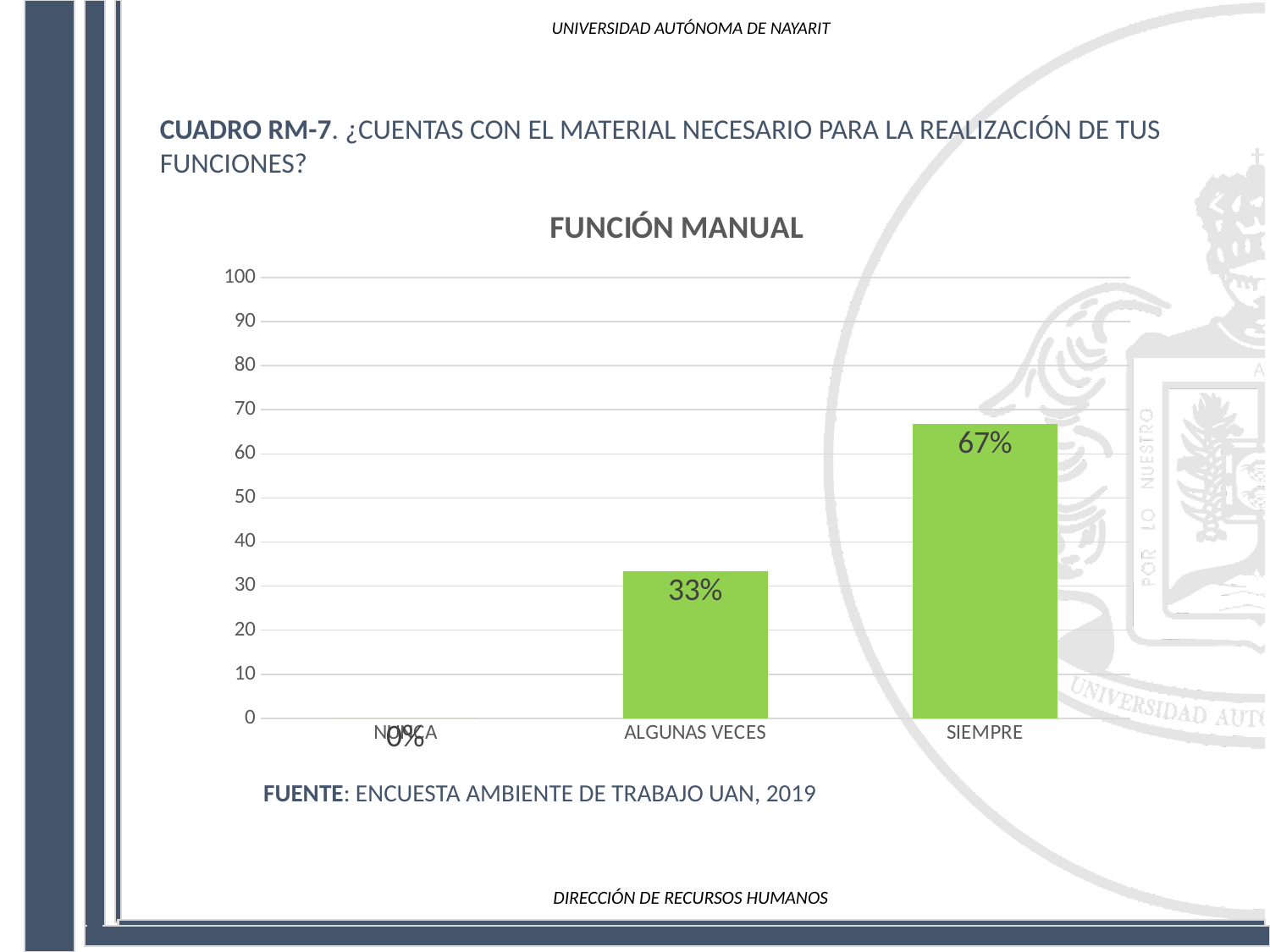
Which category has the highest value? SIEMPRE What is the difference between the values for SIEMPRE and ALGUNAS VECES? 34% What kind of chart is shown on the slide? bar chart How many categories are shown on the x axis? 3 What is the value for SIEMPRE? 67% Which is larger, the value for ALGUNAS VECES or the value for SIEMPRE? SIEMPRE What is the value for NUNCA? 0% Is the value for ALGUNAS VECES greater or less than 40? less What is the title of the chart? FUNCIÓN MANUAL Is the value for SIEMPRE greater or less than 60? greater What is the value for ALGUNAS VECES? 33% Which category has the lowest value? NUNCA